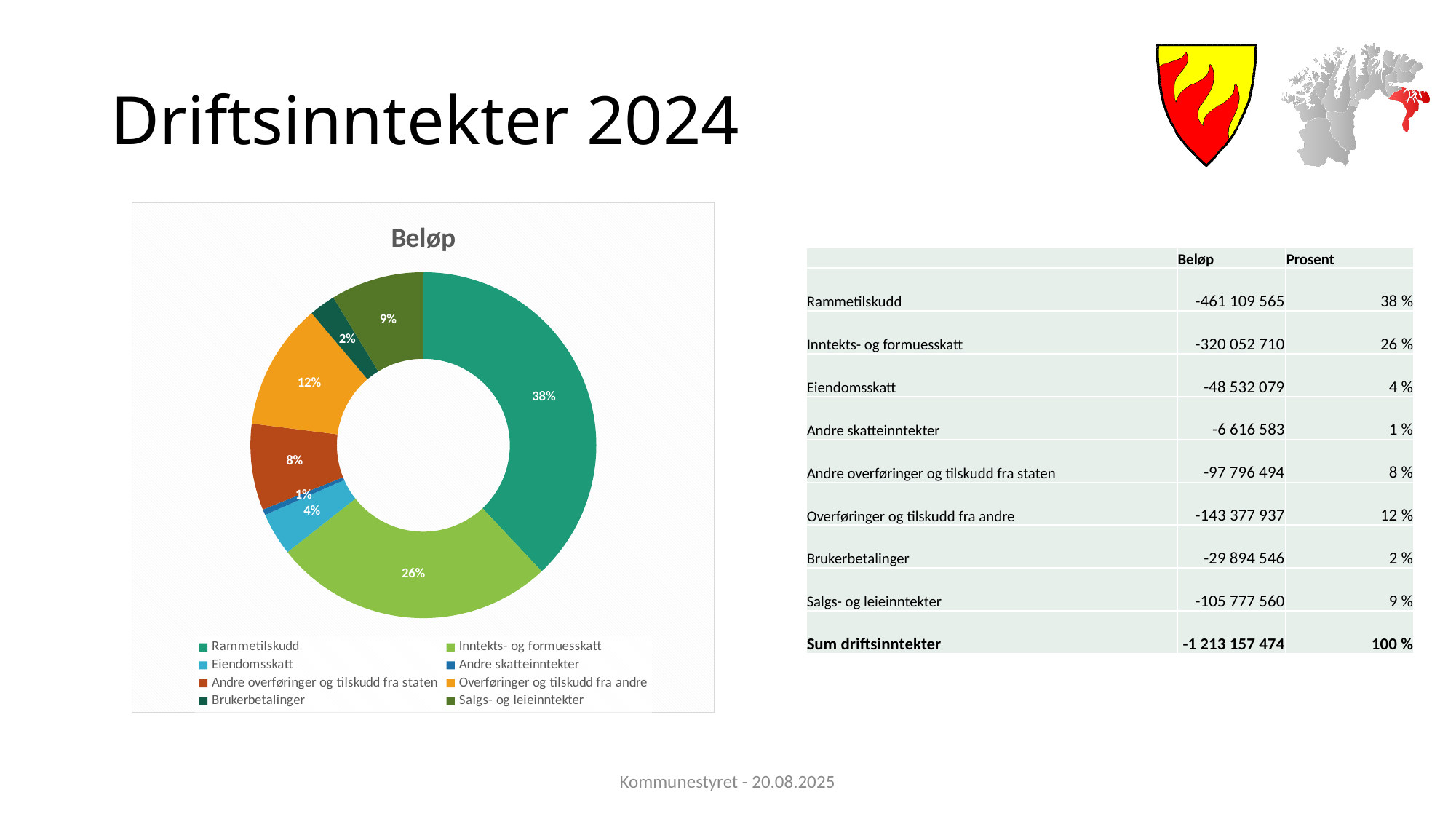
What is the difference in percentage points between Rammetilskudd and Inntekts- og formuesskatt? 12 What percentage is shown for Brukerbetalinger in the chart? 2% What percentage is shown for Salgs- og leieinntekter in the chart? 9% What kind of chart is shown on the slide? Doughnut chart Which category has the largest share in the chart? Rammetilskudd Which has a larger share, Eiendomsskatt or Andre overføringer og tilskudd fra staten? Andre overføringer og tilskudd fra staten How many categories are shown in the chart? 8 Which category has the smallest share in the chart? Andre skatteinntekter What percentage is shown for Inntekts- og formuesskatt in the chart? 26% What share of the doughnut chart does Rammetilskudd represent? 38% What is the title of the chart? Beløp What percentage is shown for Overføringer og tilskudd fra andre in the chart? 12%